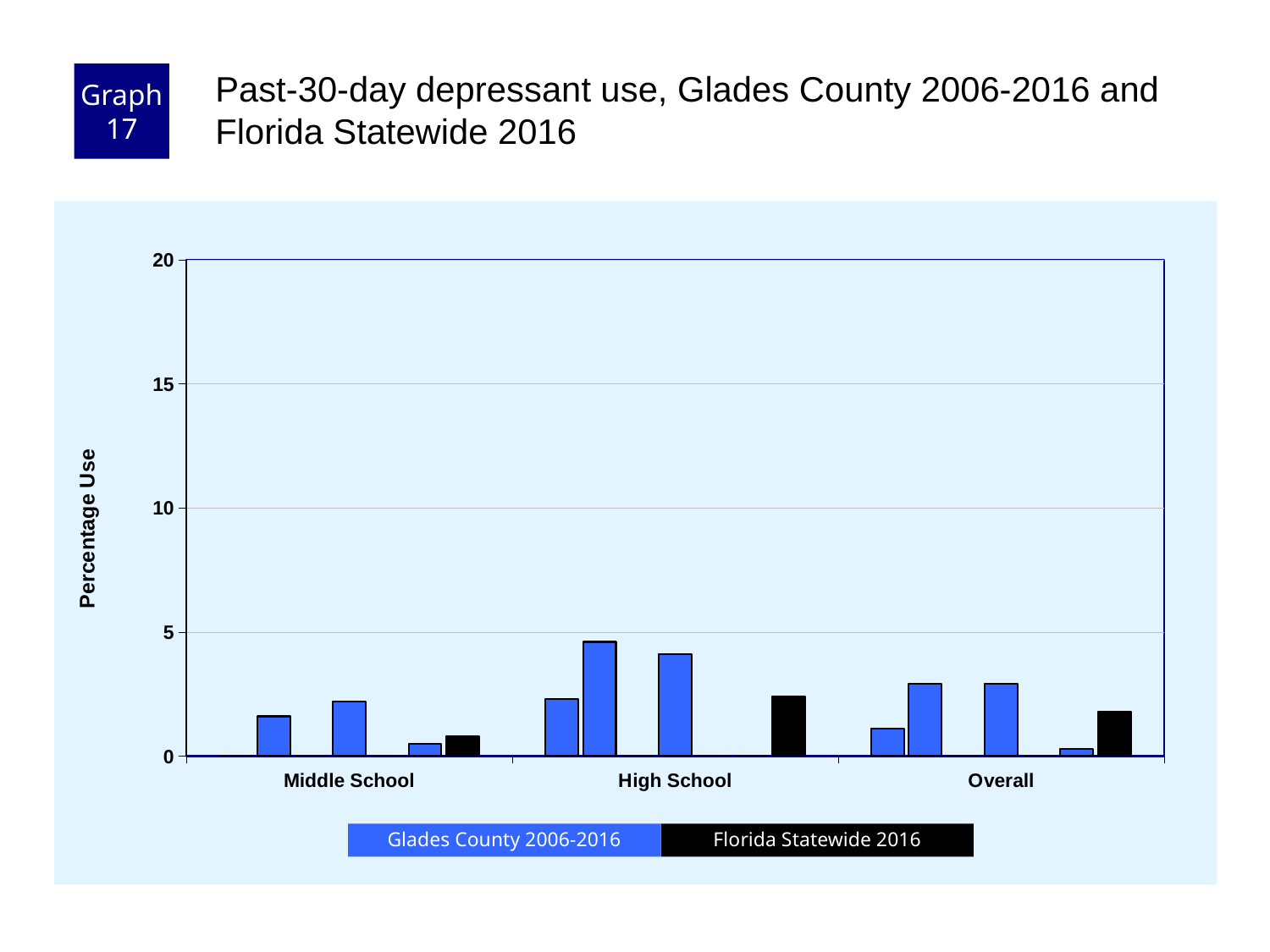
Which is larger: the Florida Statewide 2016 value for High School or for Middle School? High School What kind of chart is shown on the slide? bar chart Is the Florida Statewide 2016 value for Middle School greater or less than 5? less Which category has the lowest Florida Statewide 2016 value? Middle School Which is larger: the Florida Statewide 2016 value for Overall or for Middle School? Overall What is the label on the y axis? Percentage Use Which category has the highest Florida Statewide 2016 value? High School Are any of the bars in the chart greater than 10? No How many categories are shown on the x axis? 3 What colour represents Florida Statewide 2016 in the legend? black Is the Florida Statewide 2016 value for High School greater or less than 5? less How many series does the legend list? 2